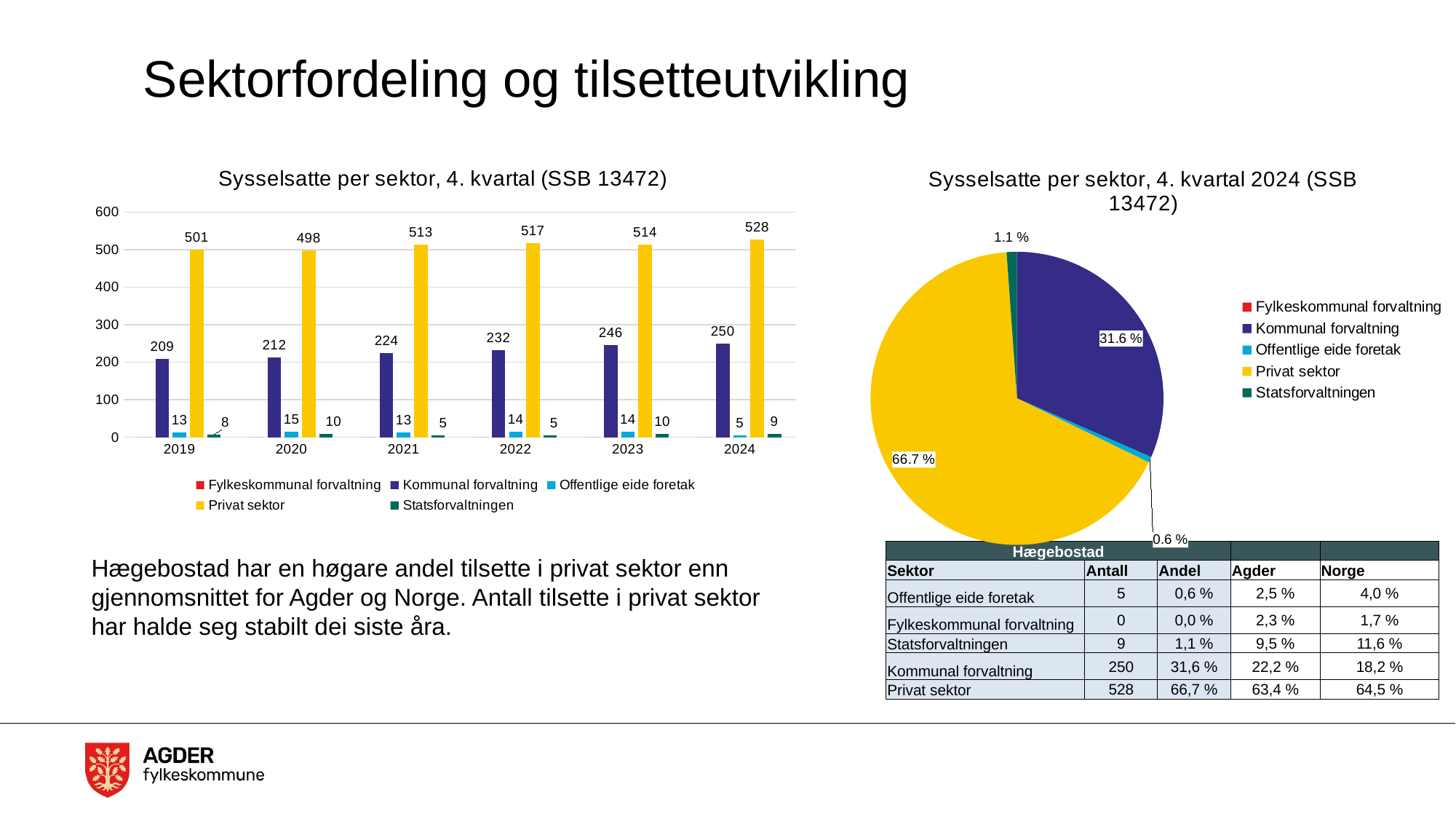
In the bar chart 'Sysselsatte per sektor, 4. kvartal (SSB 13472)', how many years are shown on the x axis? 6 In the bar chart 'Sysselsatte per sektor, 4. kvartal (SSB 13472)', does Kommunal forvaltning rise or fall from 2019 to 2024? rise In the bar chart 'Sysselsatte per sektor, 4. kvartal (SSB 13472)', what is the difference between the Privat sektor values for 2024 and 2019? 27 In the bar chart 'Sysselsatte per sektor, 4. kvartal (SSB 13472)', what is the value for Kommunal forvaltning in 2019? 209 In the bar chart 'Sysselsatte per sektor, 4. kvartal (SSB 13472)', what is the value for Offentlige eide foretak in 2020? 15 In the pie chart 'Sysselsatte per sektor, 4. kvartal 2024 (SSB 13472)', which is larger, Kommunal forvaltning or Statsforvaltningen? Kommunal forvaltning In the bar chart 'Sysselsatte per sektor, 4. kvartal (SSB 13472)', how many series does the legend list? 5 In the bar chart 'Sysselsatte per sektor, 4. kvartal (SSB 13472)', what is the value for Privat sektor in 2024? 528 In the pie chart 'Sysselsatte per sektor, 4. kvartal 2024 (SSB 13472)', what share does Privat sektor have? 66.7 % In the bar chart 'Sysselsatte per sektor, 4. kvartal (SSB 13472)', which year has the highest value for Privat sektor? 2024 In the bar chart 'Sysselsatte per sektor, 4. kvartal (SSB 13472)', which year has the lowest value for Kommunal forvaltning? 2019 What kind of chart is 'Sysselsatte per sektor, 4. kvartal 2024 (SSB 13472)' on the right of the slide? pie chart